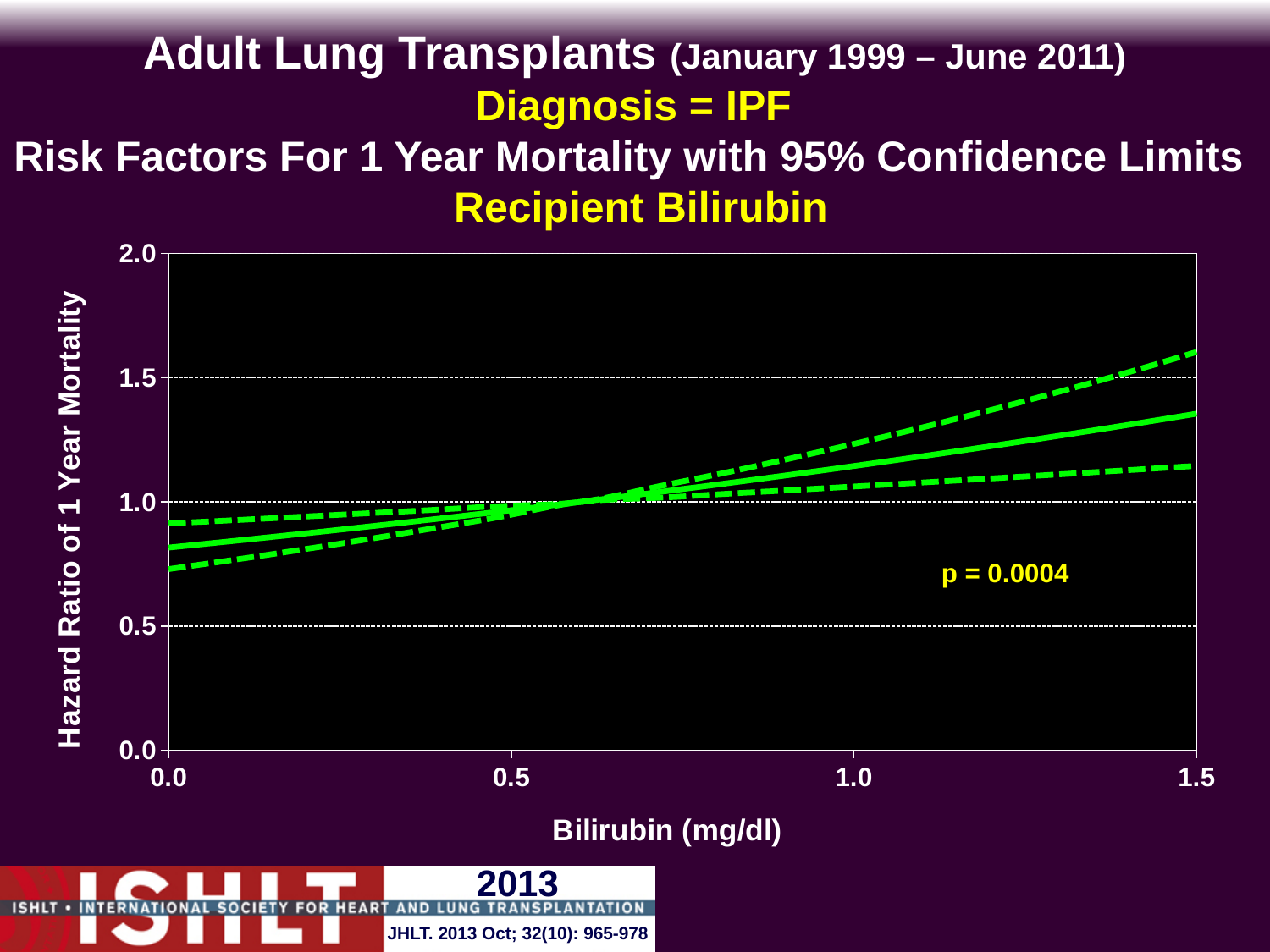
How many lines are plotted on the chart? 3 Is the lower 95% confidence limit (lower dashed line) at a bilirubin of 0.0 mg/dl greater or less than 1.0? less Does the hazard ratio of 1 year mortality rise or fall as recipient bilirubin increases along the x axis? rise Is the hazard ratio (solid line) at a bilirubin of 0.0 mg/dl greater or less than 1.0? less Is the upper 95% confidence limit (upper dashed line) at a bilirubin of 1.5 mg/dl greater or less than 1.5? greater What is the label of the x axis of the chart? Bilirubin (mg/dl) What p-value is printed on the chart? p = 0.0004 Is the hazard ratio (solid line) larger at a bilirubin of 0.0 mg/dl or at 1.5 mg/dl? 1.5 mg/dl What kind of chart is shown on the slide? line chart